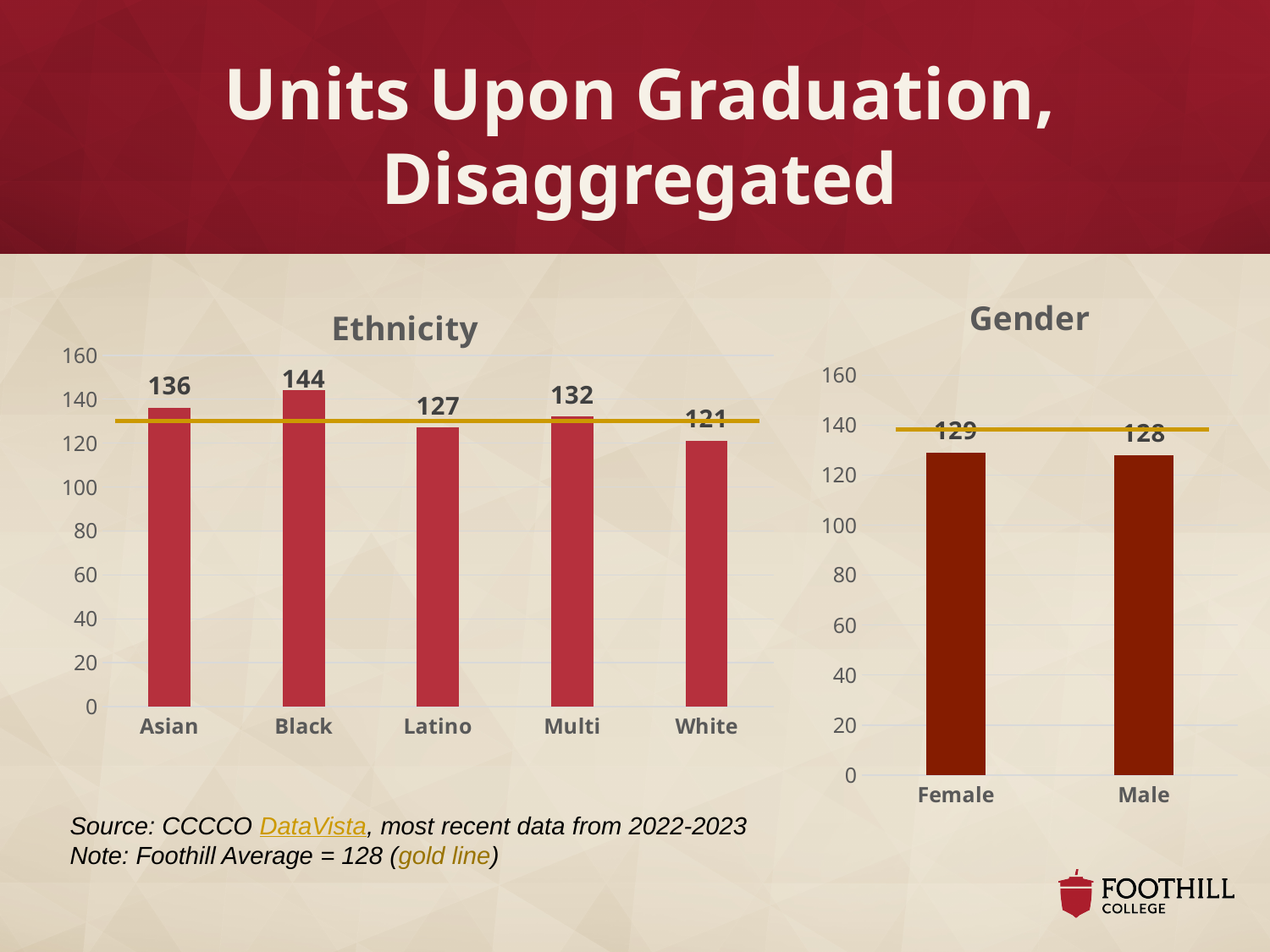
In the Gender chart, what is the value for Male? 128 What kind of chart is the Gender chart? Bar chart In the Ethnicity chart, which category has the highest value? Black In the Ethnicity chart, which category has the lowest value? White In the Ethnicity chart, what is the difference between the values for Black and White? 23 In the Ethnicity chart, what is the value for Latino? 127 According to the note on the slide, what does the gold line in the charts represent? Foothill Average = 128 In the Gender chart, what is the difference between the values for Female and Male? 1 In the Ethnicity chart, what is the value for Asian? 136 In the Ethnicity chart, how many categories are shown on the x axis? 5 In the Gender chart, what is the value for Female? 129 In the Ethnicity chart, which is larger, the value for Multi or the value for Latino? Multi